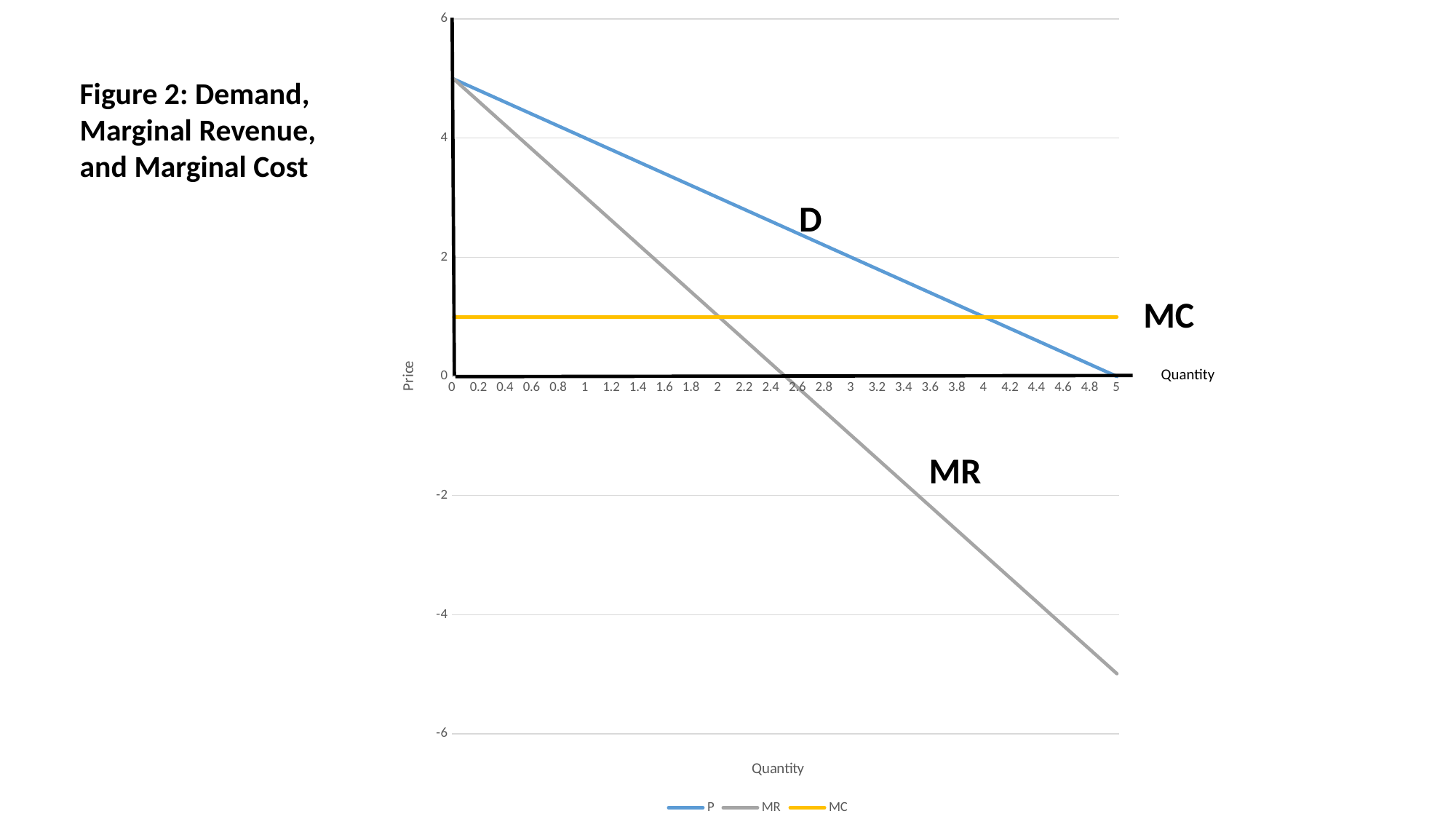
What are the series names listed in the legend? P, MR, MC Is the value of the D line at quantity 0 greater or less than 4? greater Is the value of the MC line greater or less than 2? less Is the value of the MC line greater or less than 0? greater What is the title of the figure on the slide? Figure 2: Demand, Marginal Revenue, and Marginal Cost Does the MR line rise or fall as quantity increases? fall What kind of chart is shown on the slide? line chart How many series does the legend list? 3 At quantity 3, which line has the higher value, D or MR? D What is the value of the D (P) line at quantity 5? 0